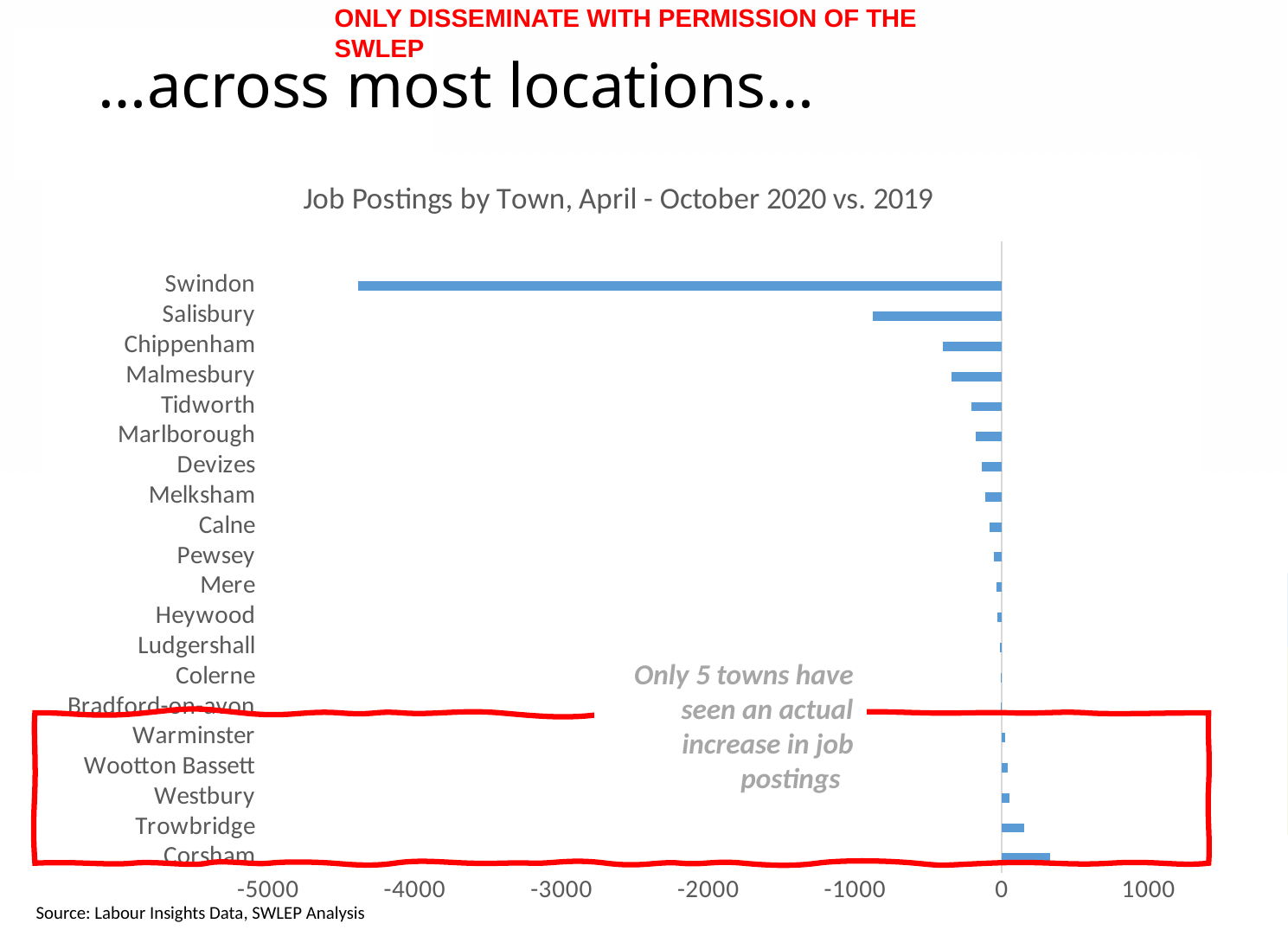
Which has the larger value, Corsham or Trowbridge? Corsham Which has the larger value, Swindon or Salisbury? Salisbury Which town has the highest value on the chart? Corsham How many towns are listed on the chart? 20 According to the annotation on the chart, how many towns have seen an actual increase in job postings? 5 What kind of chart is shown on the slide? bar chart Is the value for Corsham greater or less than 0? greater Is the value for Salisbury greater or less than -1000? greater Which town has the lowest (most negative) value on the chart? Swindon What is the title of the chart? Job Postings by Town, April - October 2020 vs. 2019 Is the value for Chippenham greater or less than 0? less